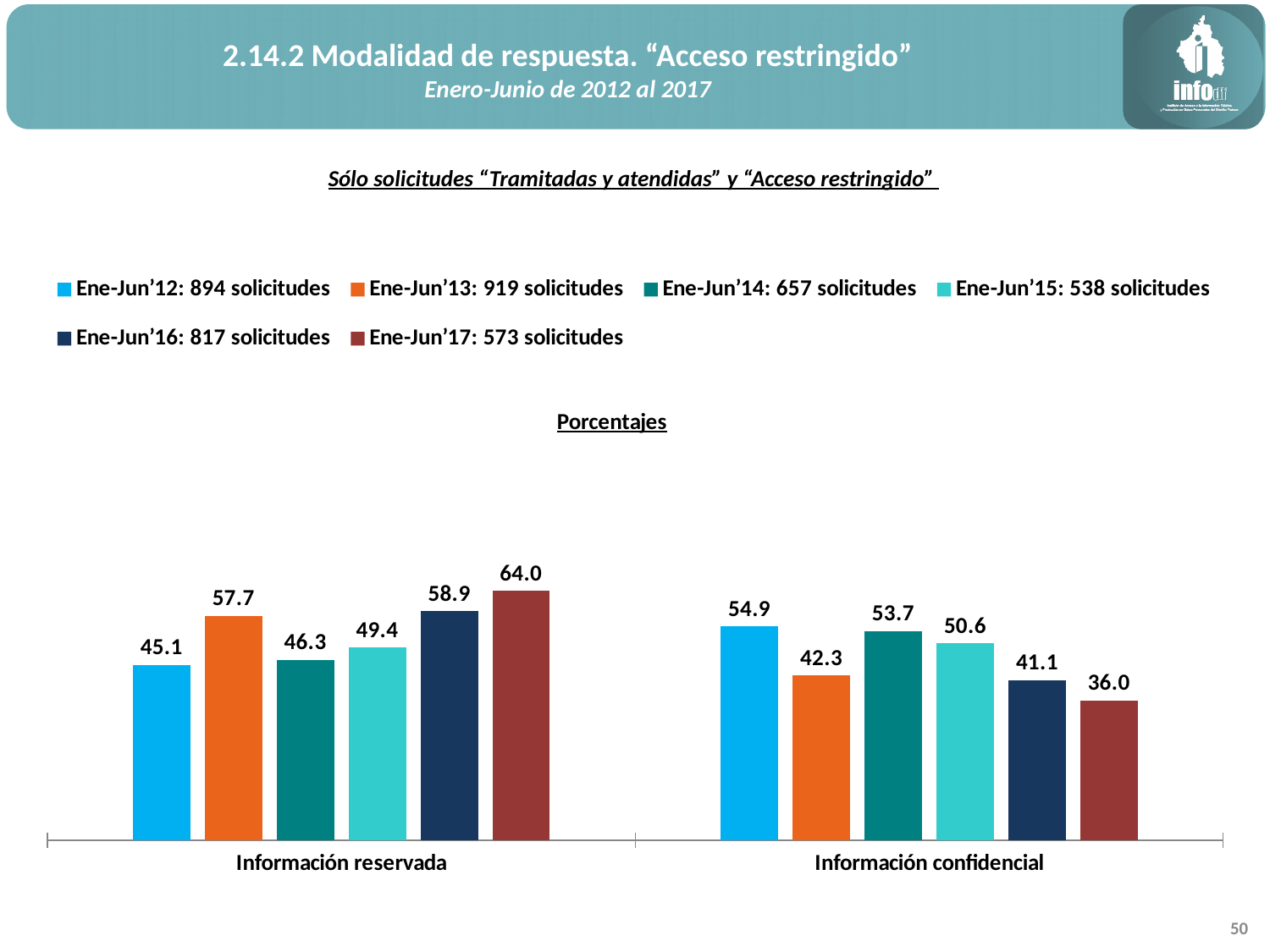
What kind of chart is shown on the slide? Bar chart How many series does the legend list? 6 What is the difference between the Ene-Jun'13 values for Información reservada and Información confidencial? 15.4 Which is larger: the Ene-Jun'16 value for Información reservada or for Información confidencial? Información reservada Which series has the lowest value in the Información confidencial category? Ene-Jun'17 What is the value for Ene-Jun'15 in the Información reservada category? 49.4 According to the legend, how many solicitudes were there in Ene-Jun'14? 657 How many categories are shown on the x axis? 2 What is the value for Ene-Jun'17 in the Información reservada category? 64.0 What is the value for Ene-Jun'12 in the Información confidencial category? 54.9 Which series has the highest value in the Información reservada category? Ene-Jun'17 What is the total of the Ene-Jun'12 values across both categories? 100.0